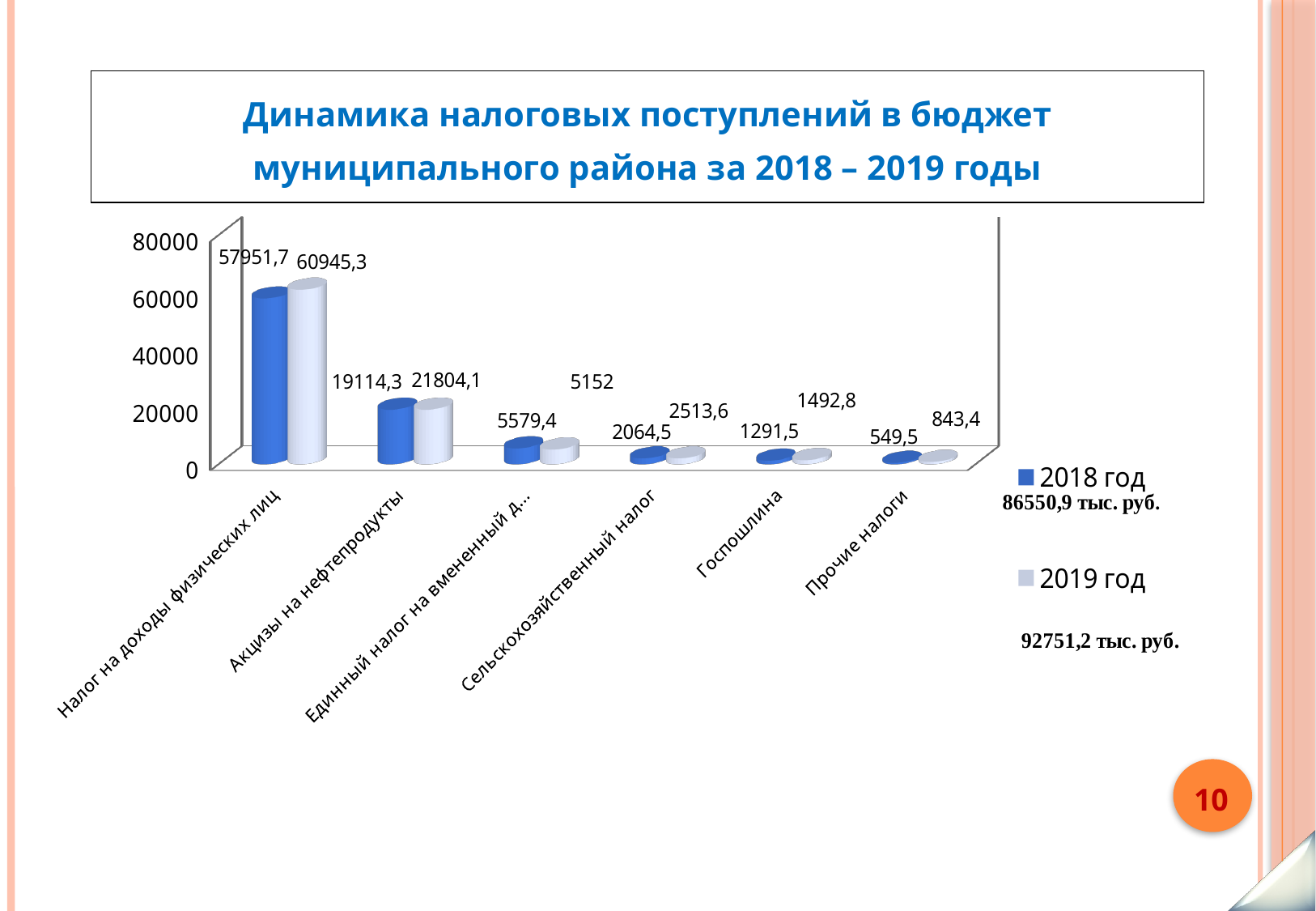
How many categories are shown on the x axis? 6 What kind of chart is shown on the slide? Bar chart How many series does the legend list? 2 What is the 2018 год value for Прочие налоги? 549,5 Which category has the highest 2019 год value? Налог на доходы физических лиц What is the 2019 год value for Акцизы на нефтепродукты? 21804,1 What is the difference between the 2019 год and 2018 год values for Сельскохозяйственный налог? 449,1 Which category has the lowest 2018 год value? Прочие налоги What is the 2019 год value for Госпошлина? 1492,8 What is the 2018 год value for Налог на доходы физических лиц? 57951,7 For the category labelled Единый налог на вмененный д..., which year has the larger value, 2018 год or 2019 год? 2018 год What is the difference between the 2019 год and 2018 год values for Налог на доходы физических лиц? 2993,6